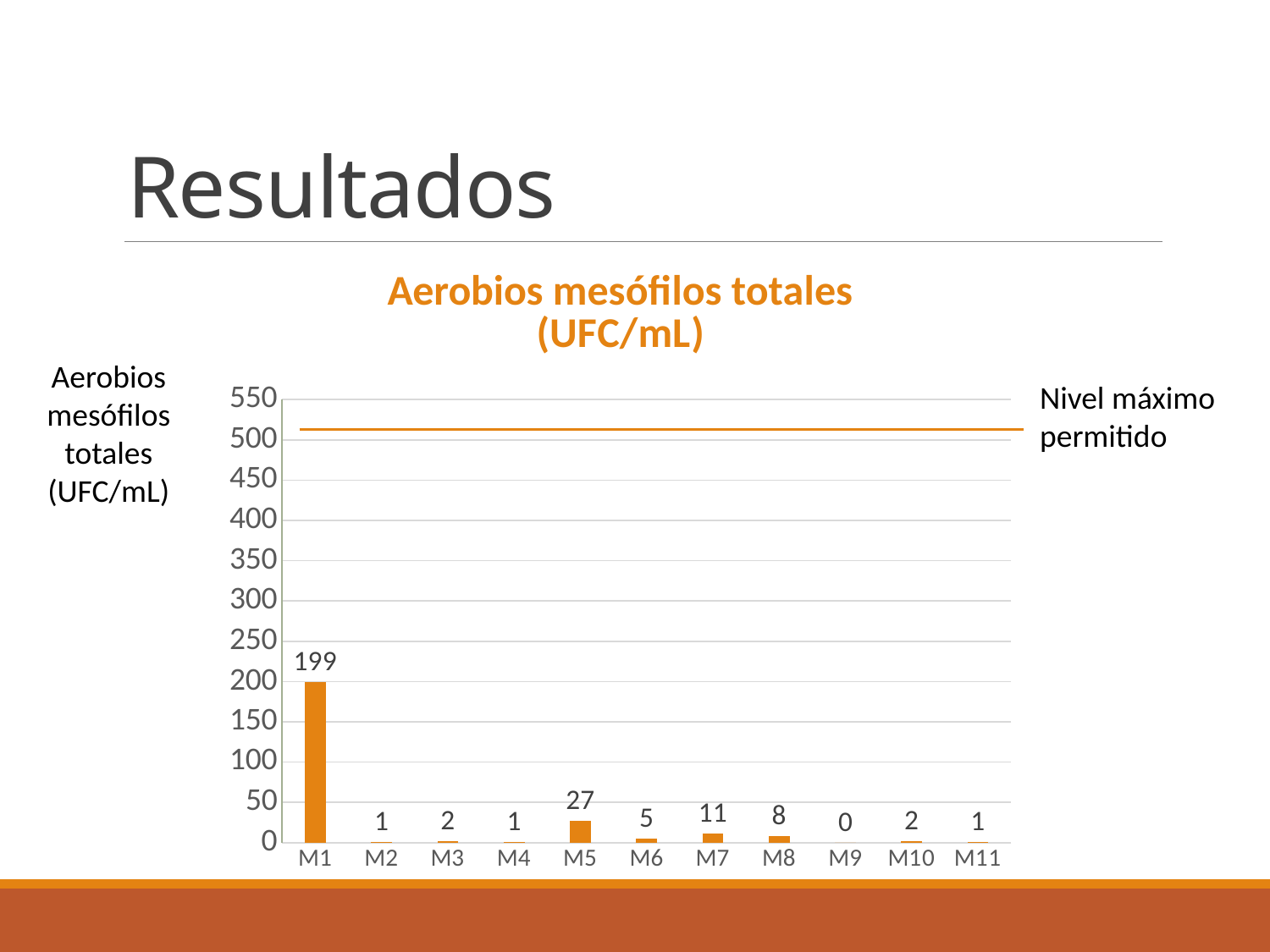
Which category has the highest value? M1 Is the value for M1 greater or less than 500? less Which category has the lowest value? M9 How many categories are shown on the x axis? 11 What is the value for M7? 11 What is the value for M9? 0 What is the difference between the values for M1 and M5? 172 What is the title of the chart? Aerobios mesófilos totales (UFC/mL) What kind of chart is this? bar chart What is the value for M5? 27 What is the value for M1? 199 Which is larger, the value for M7 or the value for M8? M7